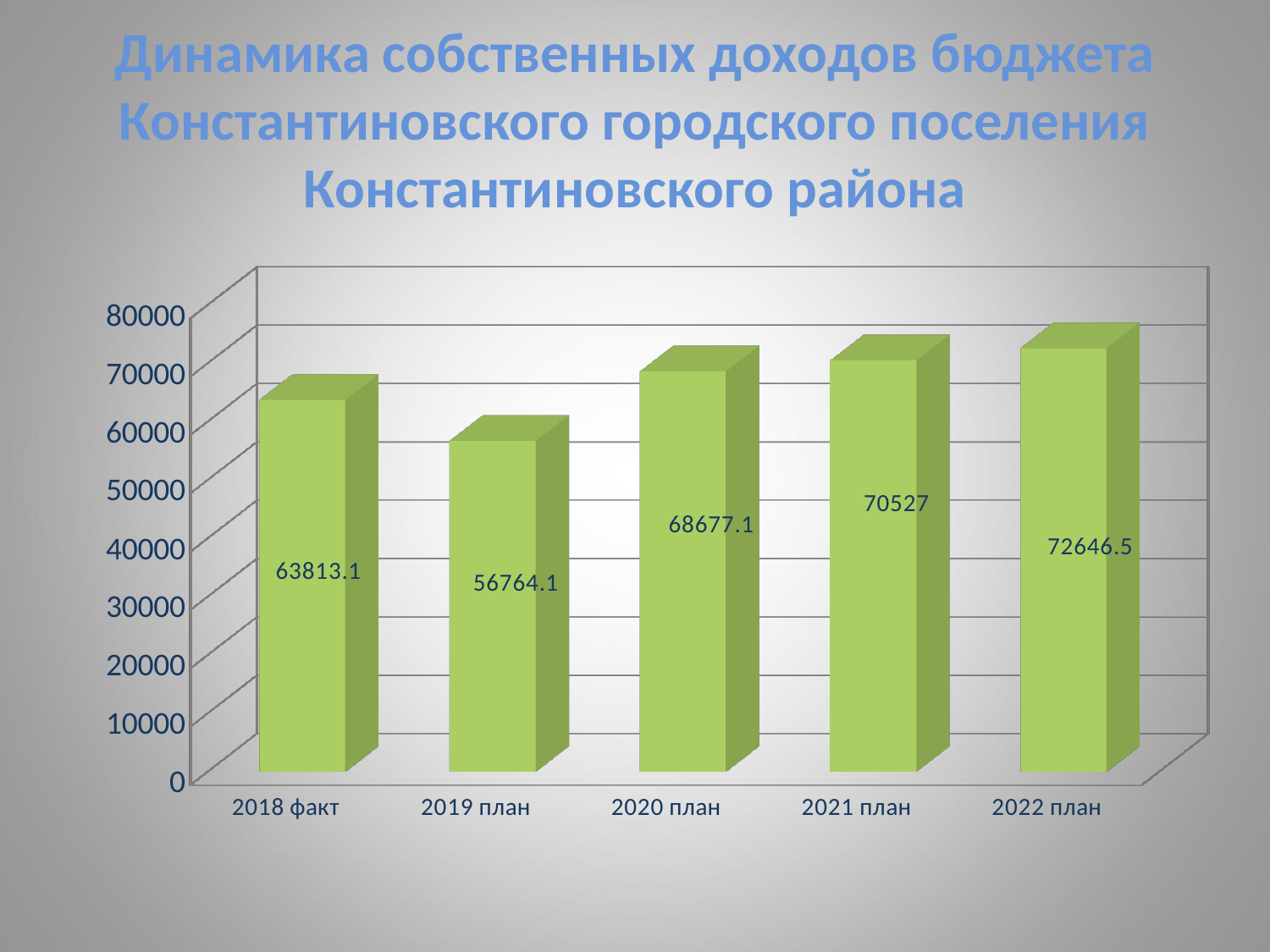
Which category has the lowest value? 2019 план What is the value for 2018 факт? 63813.1 What is the value for 2019 план? 56764.1 What is the difference between the values for 2022 план and 2019 план? 15882.4 How many categories are shown on the x axis? 5 What kind of chart is shown on the slide? Bar chart Which is larger, the value for 2020 план or the value for 2018 факт? 2020 план What is the value for 2022 план? 72646.5 What is the difference between the values for 2018 факт and 2019 план? 7049 Do the values rise or fall from 2019 план to 2022 план? Rise Which category has the highest value? 2022 план What is the value for 2021 план? 70527